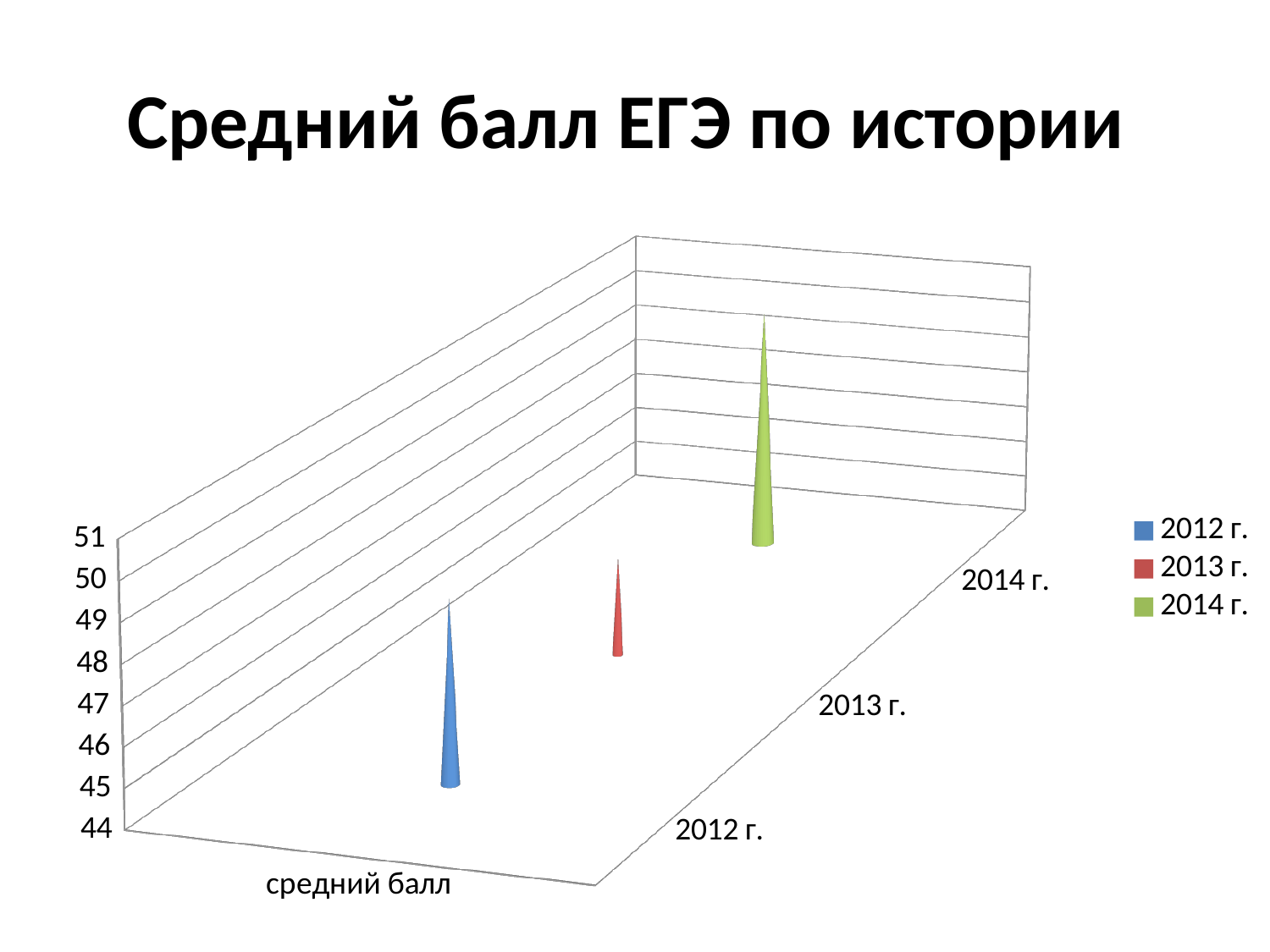
Is the value for 2014 г. greater or less than 48? greater What is the lowest value shown on the vertical axis? 44 Which year has the lowest average score in the chart? 2013 г. What is the title of the chart? Средний балл ЕГЭ по истории Which is larger, the value for 2012 г. or the value for 2013 г.? 2012 г. Which year has the highest average score in the chart? 2014 г. Which is larger, the value for 2014 г. or the value for 2012 г.? 2014 г. How many series does the legend list? 3 Is the value for 2012 г. greater or less than 46? greater What kind of chart is shown on the slide? bar chart Is the value for 2013 г. greater or less than 49? less What is the label of the category on the horizontal axis? средний балл